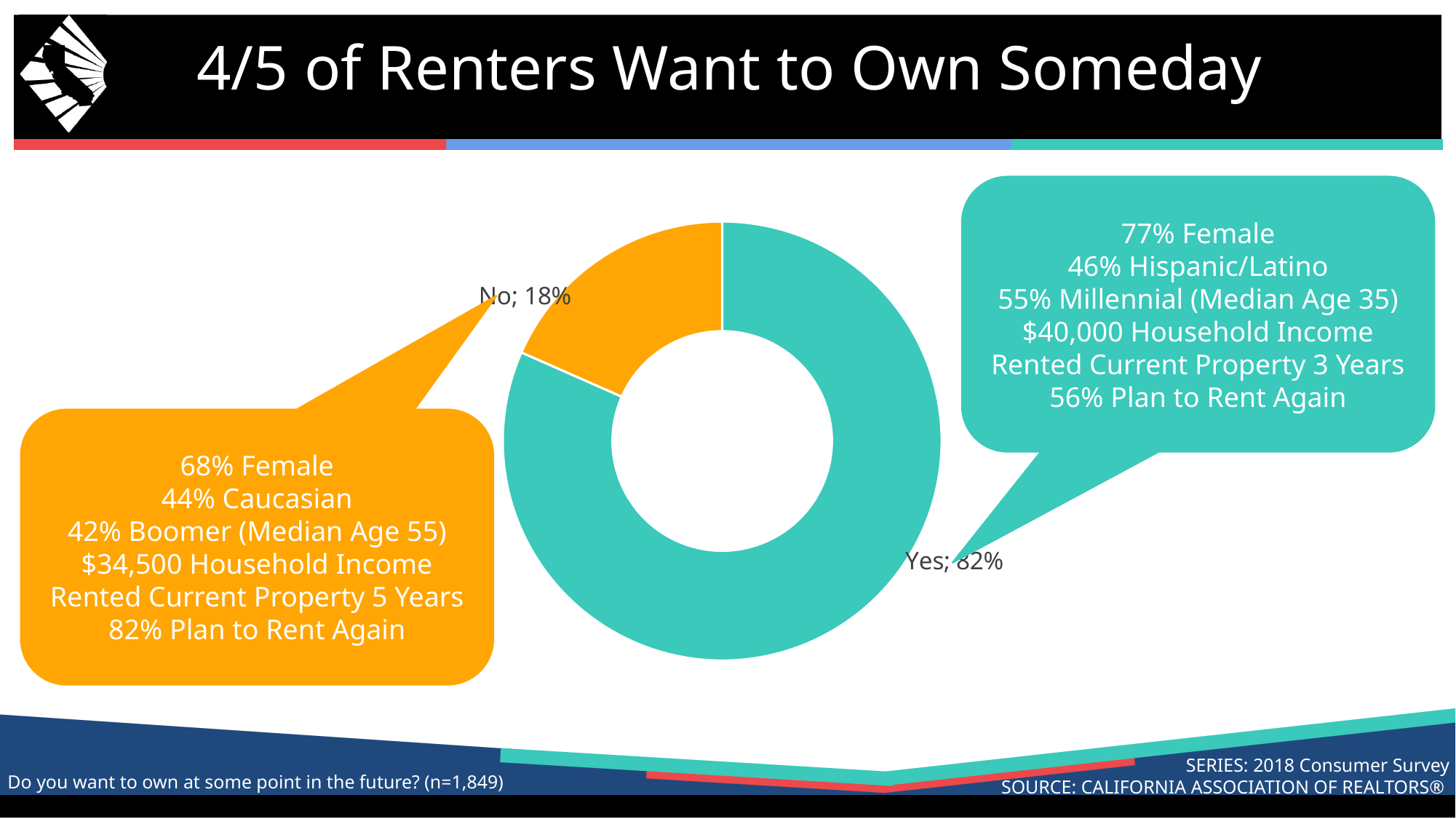
Which is larger, the "Yes" share or the "No" share? Yes Which response has the largest share of the chart? Yes What percentage of renters answered "Yes" to wanting to own at some point in the future? 82% What is the sample size (n) of the survey question shown on the slide? 1,849 What percentage of renters answered "No" to wanting to own at some point in the future? 18% Which response has the smallest share of the chart? No What is the difference in percentage points between the "Yes" and "No" shares? 64 What kind of chart is shown on the slide? Pie chart (doughnut) What colour is the "Yes" slice of the chart? Teal What share of the pie does the "No" slice represent? 18% What colour is the "No" slice of the chart? Orange How many categories are shown in the chart? 2